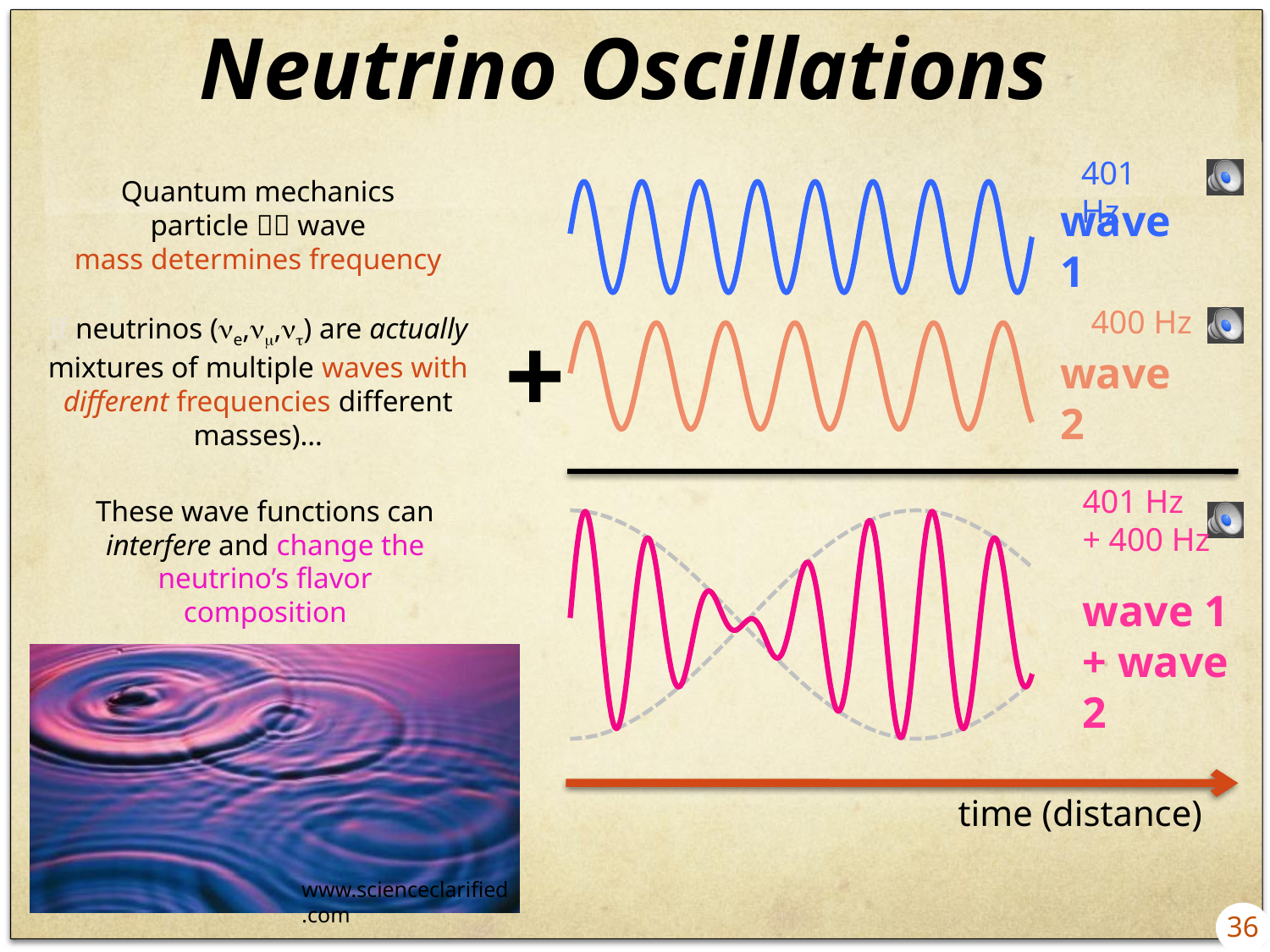
Which has the higher labelled frequency, wave 1 or wave 2? wave 1 How many separate wave plots are shown on the right side of the slide? 3 What frequency is labelled for wave 2 in the wave diagram? 400 Hz What is the label of the bottom (pink) wave plot? wave 1 + wave 2 What frequency is labelled for wave 1 in the wave diagram? 401 Hz What is the label on the horizontal axis of the wave diagram? time (distance) What colour is wave 1 drawn in? blue What frequencies are listed above the bottom combined wave plot? 401 Hz + 400 Hz What is the difference between the labelled frequencies of wave 1 and wave 2? 1 Hz